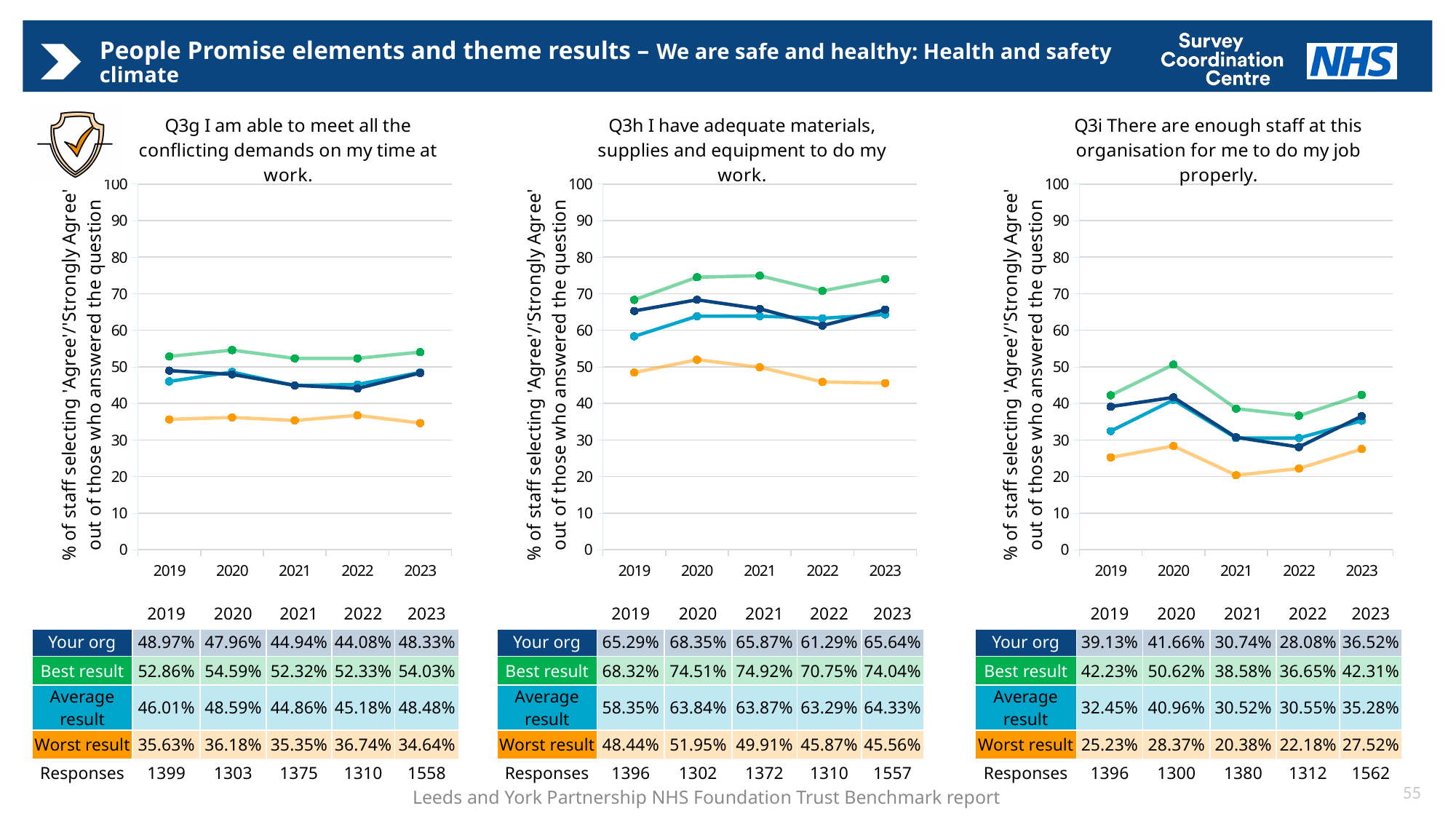
In the Q3h chart, is the 'Worst result' value for 2022 greater or less than 50? less What type of chart is used for Q3i? Line chart How many series are shown in the Q3h chart? 4 In the Q3h chart, what is the difference between the 'Best result' and 'Your org' values for 2023? 8.40% In the Q3i chart (There are enough staff at this organisation for me to do my job properly), what is the 'Worst result' value for 2021? 20.38% How many years are plotted on the x axis of the Q3g chart? 5 In the Q3g chart (I am able to meet all the conflicting demands on my time at work), what is the 'Your org' value for 2023? 48.33% In the Q3h chart (I have adequate materials, supplies and equipment to do my work), what is the 'Best result' value for 2021? 74.92% In the Q3i chart, which is larger for 2019: the 'Your org' value or the 'Average result' value? Your org In the Q3i chart, which year has the highest 'Your org' value? 2020 In the Q3i chart, does the 'Your org' line rise or fall from 2020 to 2022? fall In the Q3g chart, which year has the lowest 'Your org' value? 2022